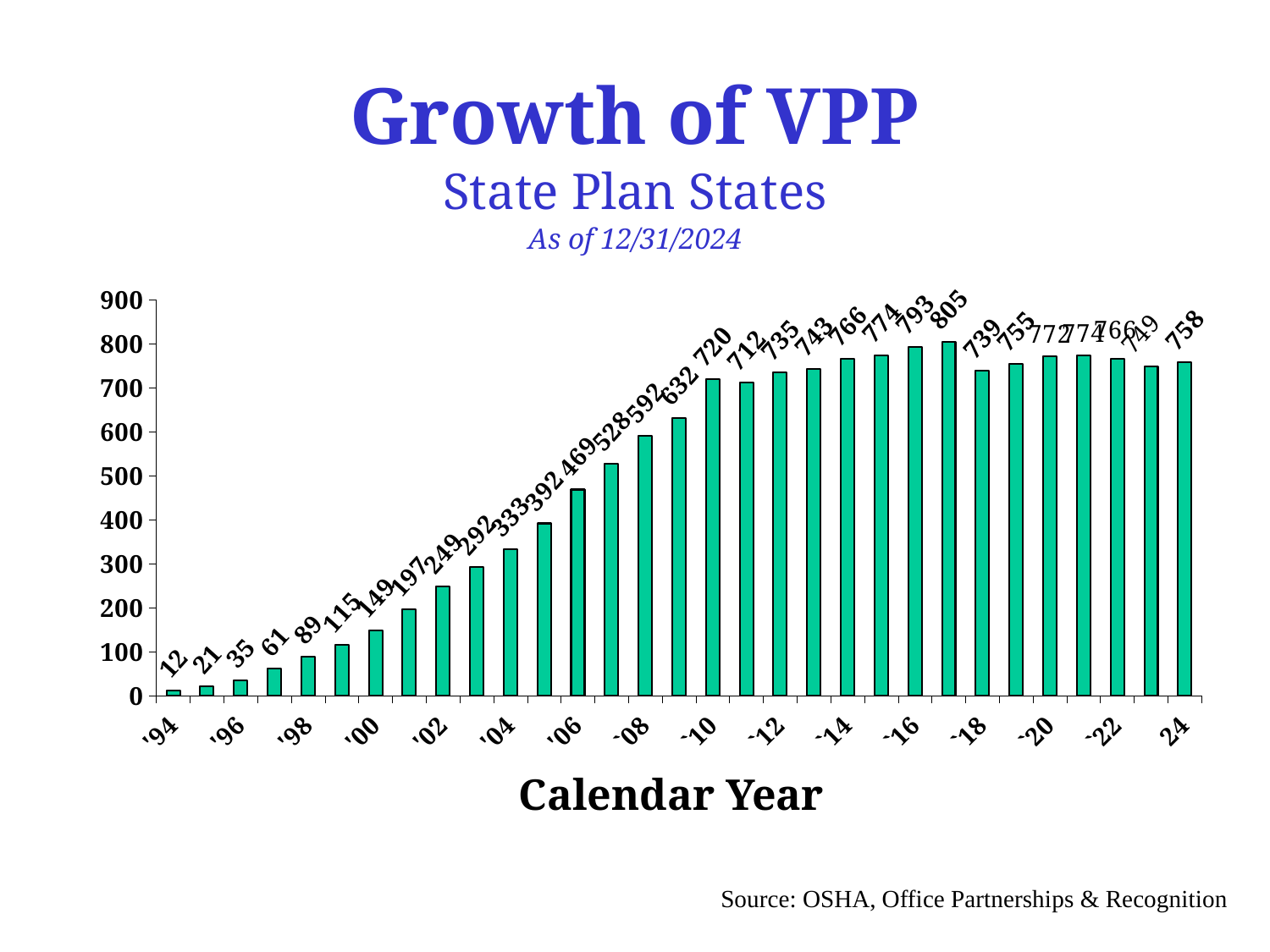
How many bars are plotted on the chart? 31 Which year has the lowest value? '94 What kind of chart is shown on the slide? bar chart What is the value for '17? 805 What is the value for '10? 720 Is the value for '06 greater or less than 400? greater Which is larger, the value for '16 or the value for '18? '16 What is the title of the x axis? Calendar Year What is the value for '24? 758 What is the difference between the values for '10 and '11? 8 Which year has the highest value? '17 What is the value for '94? 12